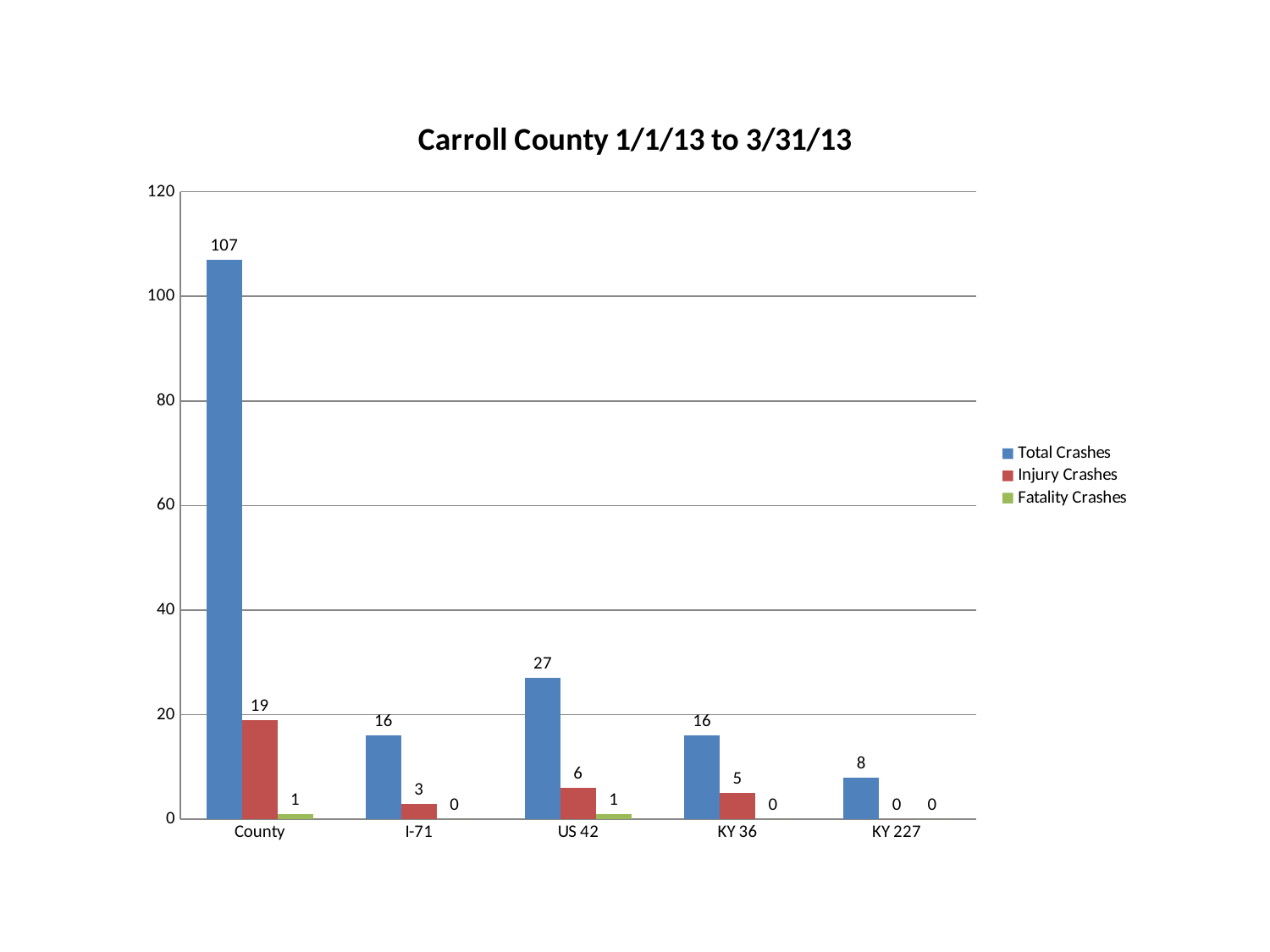
What is the value of Injury Crashes for US 42? 6 Is the value of Total Crashes for County greater or less than 100? greater What kind of chart is shown on the slide? bar chart Which category has the lowest Total Crashes? KY 227 How many categories are shown on the x axis? 5 How many series does the legend list? 3 What is the value of Fatality Crashes for KY 227? 0 What is the title of the chart? Carroll County 1/1/13 to 3/31/13 Which is larger: Injury Crashes for I-71 or Injury Crashes for KY 36? Injury Crashes for KY 36 What is the value of Total Crashes for County? 107 What is the difference between Total Crashes for US 42 and Total Crashes for KY 36? 11 Which category has the highest Total Crashes? County